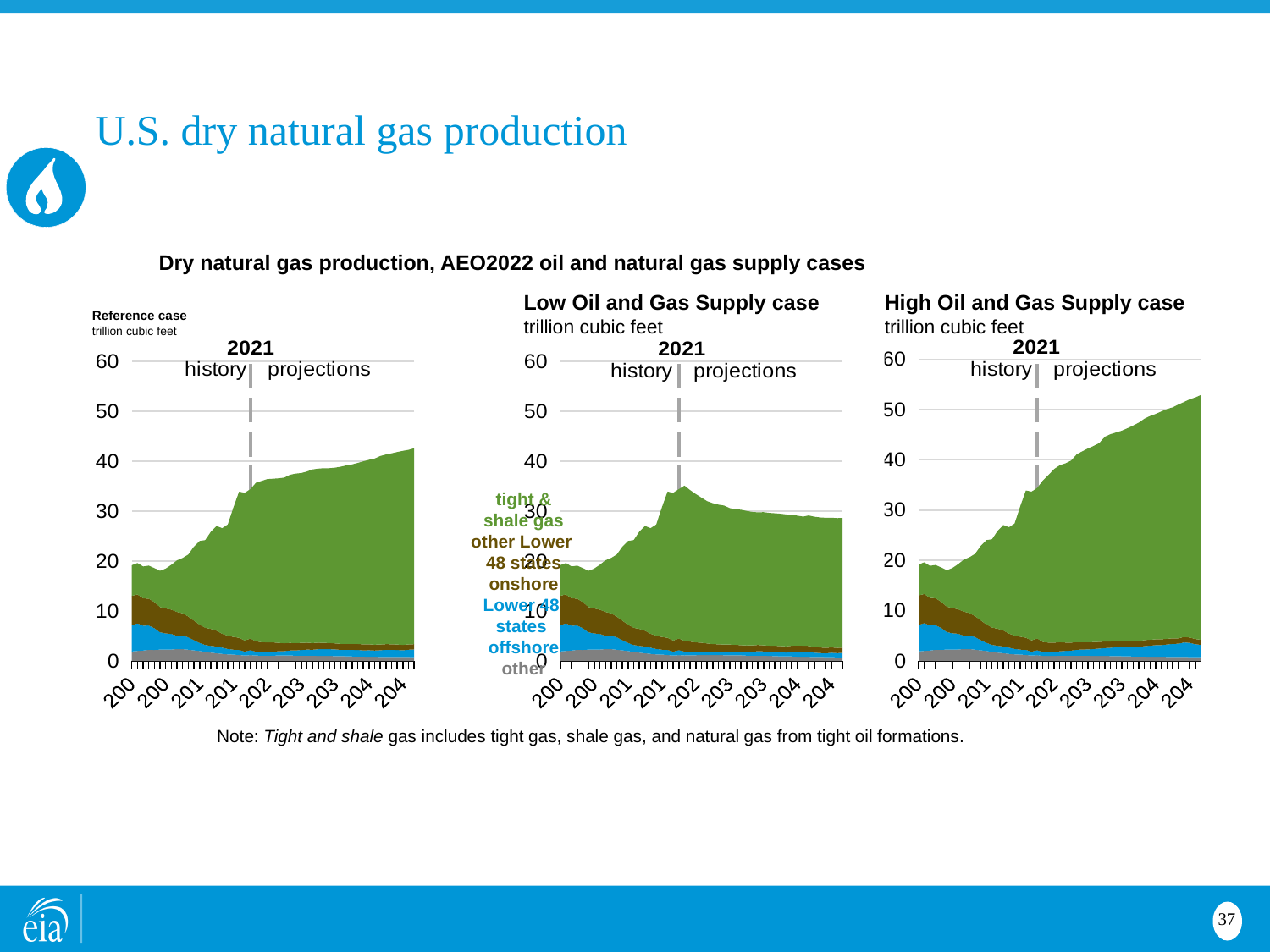
What kind of chart is the Reference case chart? stacked area chart In the High Oil and Gas Supply case chart, does total dry natural gas production rise or fall over the projection period after 2021? rise In the Reference case chart, which series accounts for the largest share of production at the end of the projection period? tight & shale gas How many series does the legend list for the Low Oil and Gas Supply case chart? 4 What year separates history from projections in the charts? 2021 In the High Oil and Gas Supply case chart, is the total dry natural gas production at the end of the projection period greater or less than 50? greater What unit is used on the y axis of the three charts? trillion cubic feet Which chart shows higher total dry natural gas production at the end of the projection period, the Low Oil and Gas Supply case or the High Oil and Gas Supply case? High Oil and Gas Supply case In the Low Oil and Gas Supply case chart, is the total dry natural gas production at the end of the projection period greater or less than 30? less In the Reference case chart, is the total dry natural gas production at the end of the projection period greater or less than 40? greater In the Low Oil and Gas Supply case chart, does total dry natural gas production rise or fall over the projection period after 2021? fall